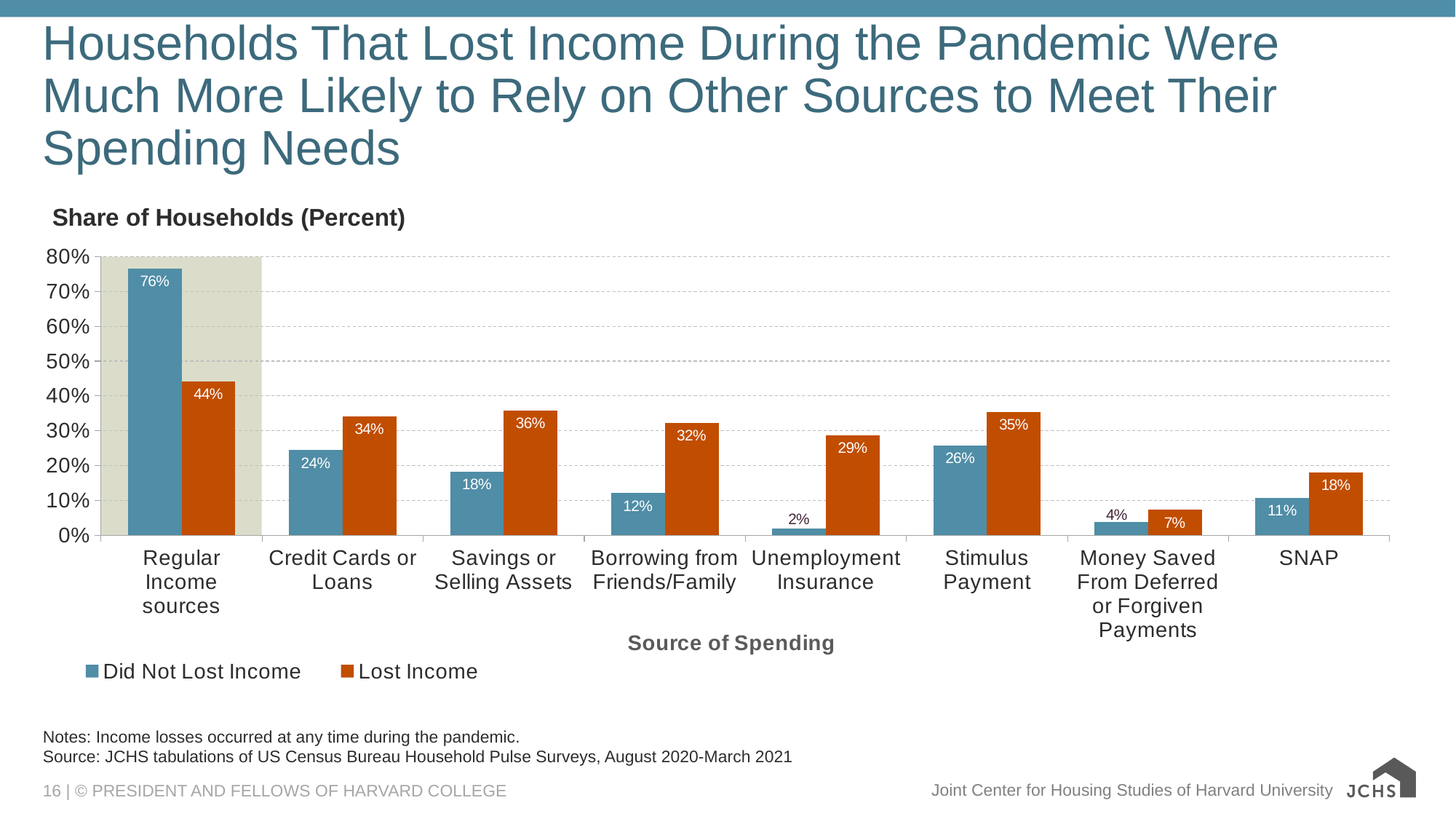
What share of households that Did Not Lost Income relied on Regular Income sources? 76% What is the value for Lost Income households for Unemployment Insurance? 29% Which source of spending has the highest value for the Lost Income series? Regular Income sources What is the value for Lost Income households for Credit Cards or Loans? 34% What is the title of the x axis? Source of Spending Which source of spending has the lowest value for the Did Not Lost Income series? Unemployment Insurance For Stimulus Payment, which series has the larger value: Did Not Lost Income or Lost Income? Lost Income How many sources of spending are shown on the x axis? 8 What kind of chart is shown on the slide? Bar chart Is the value for Lost Income households for Borrowing from Friends/Family greater or less than 30%? greater How many series does the legend list? 2 What is the difference between the Lost Income and Did Not Lost Income values for Savings or Selling Assets? 18%